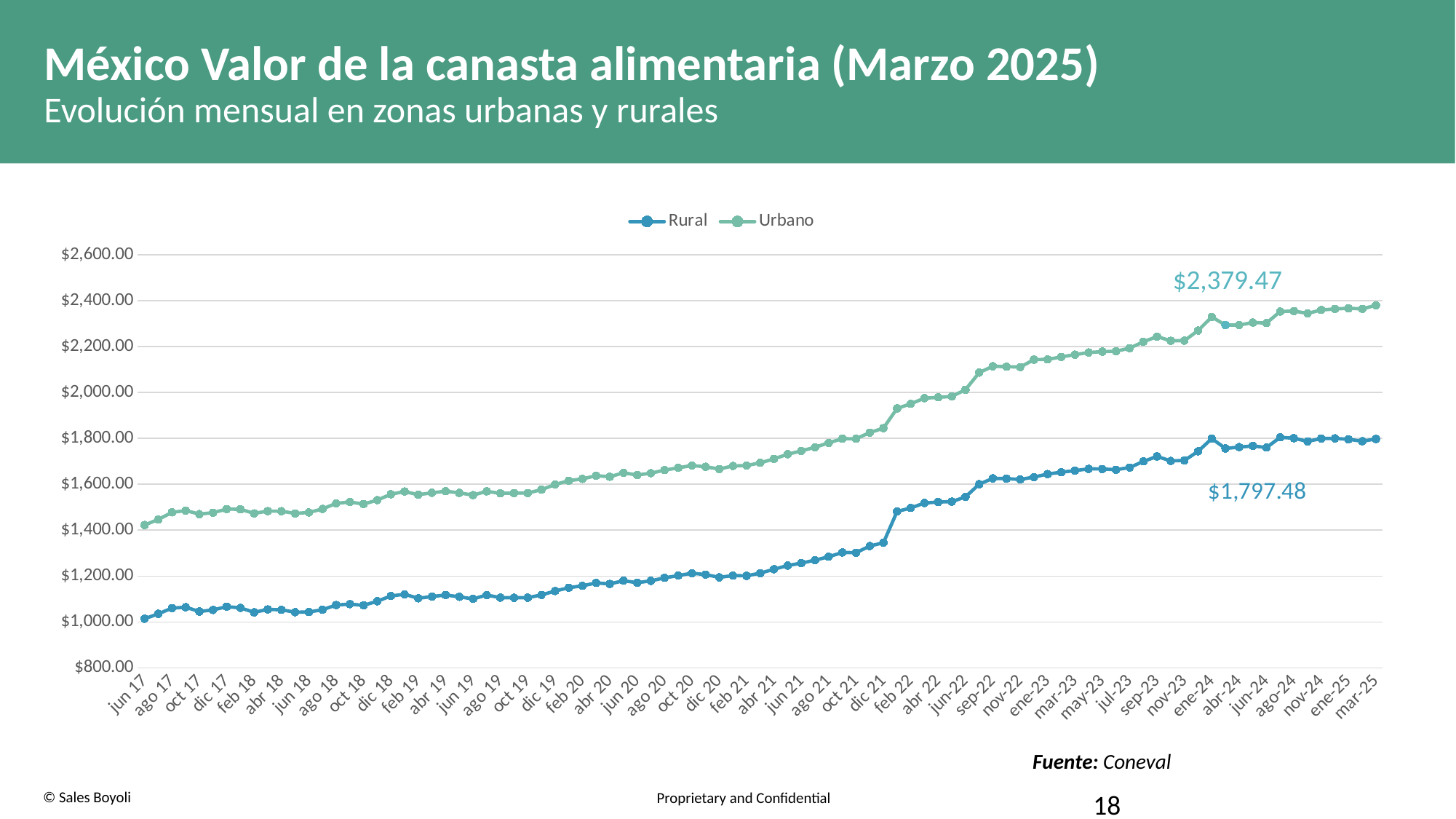
Which series has the higher value at mar-25, Rural or Urbano? Urbano How many series does the legend list? 2 Is the value for Urbano at ene-24 greater or less than $2,200.00? greater What source is cited for the chart data? Coneval Is the value for Rural at dic 21 greater or less than $1,400.00? less What kind of chart is shown on the slide? line chart Is the value for Urbano at sep-22 greater or less than $2,000.00? greater What is the value of the Urbano series at mar-25? $2,379.47 Do the values of the Rural series generally rise or fall from jun 17 to mar-25? rise What is the value of the Rural series at mar-25? $1,797.48 What is the difference between the Urbano and Rural values at mar-25? $581.99 What are the two series named in the legend? Rural and Urbano